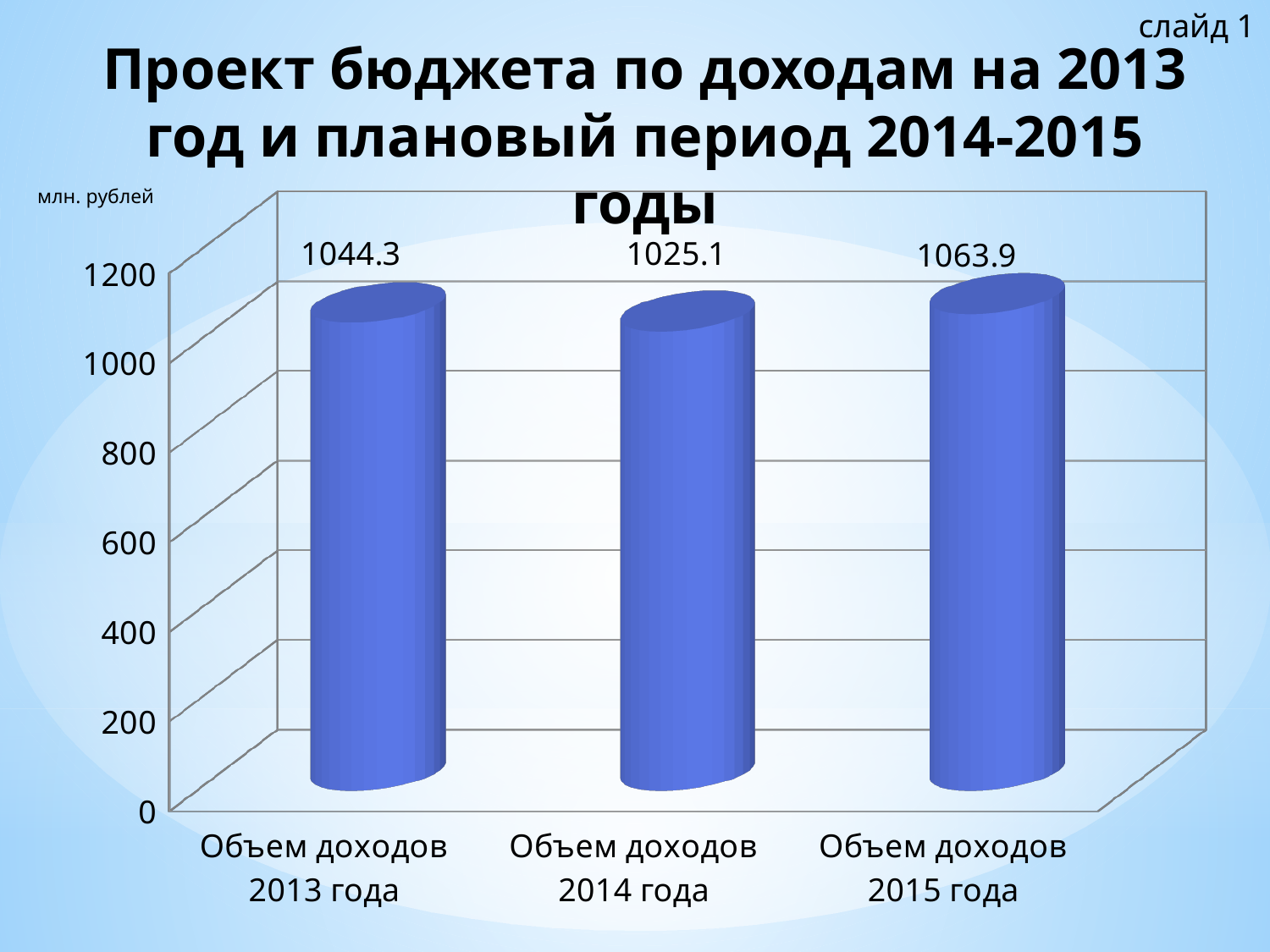
Is the value for Объем доходов 2014 года greater or less than 1000? greater What is the value for Объем доходов 2013 года? 1044.3 Which category has the highest value? Объем доходов 2015 года What is the difference between the values for Объем доходов 2013 года and Объем доходов 2014 года? 19.2 What is the difference between the values for Объем доходов 2015 года and Объем доходов 2013 года? 19.6 Which is larger, the value for Объем доходов 2013 года or Объем доходов 2014 года? Объем доходов 2013 года What is the value for Объем доходов 2015 года? 1063.9 What is the value for Объем доходов 2014 года? 1025.1 How many categories are shown in the chart? 3 What unit is indicated for the values in the chart? млн. рублей What kind of chart is shown on the slide? bar chart Which category has the lowest value? Объем доходов 2014 года